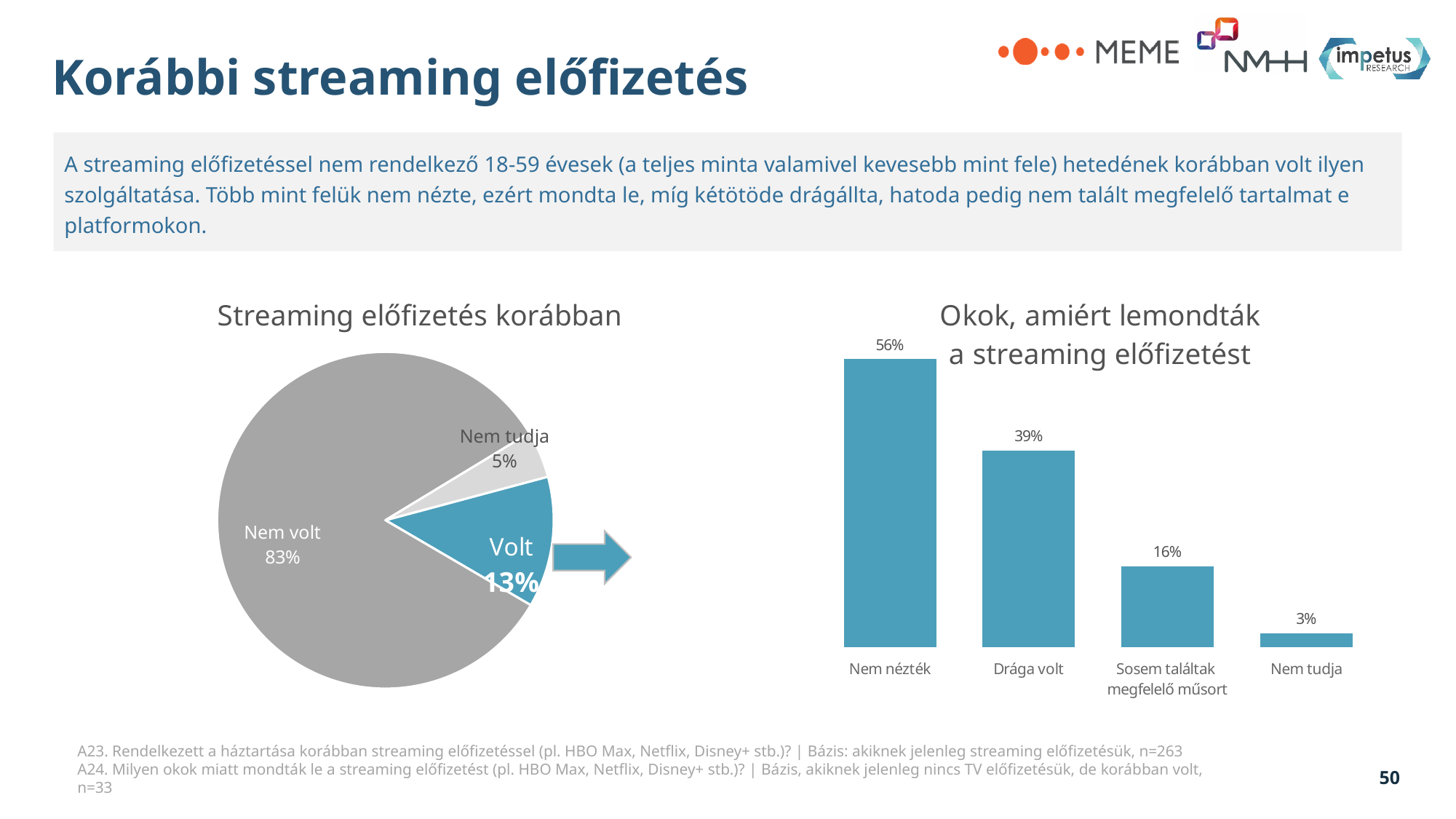
In the 'Okok, amiért lemondták a streaming előfizetést' chart, which category has the highest value? Nem nézték In the 'Streaming előfizetés korábban' chart, what share is labelled 'Nem tudja'? 5% What kind of chart is 'Okok, amiért lemondták a streaming előfizetést'? bar chart In the 'Streaming előfizetés korábban' chart, what share is labelled 'Volt'? 13% In the 'Okok, amiért lemondták a streaming előfizetést' chart, which category has the lowest value? Nem tudja How many categories are shown in the 'Okok, amiért lemondták a streaming előfizetést' chart? 4 What kind of chart is 'Streaming előfizetés korábban'? pie chart In the 'Okok, amiért lemondták a streaming előfizetést' chart, what is the value for 'Sosem találtak megfelelő műsort'? 16% In the 'Okok, amiért lemondták a streaming előfizetést' chart, what is the difference between 'Nem nézték' and 'Drága volt'? 17 percentage points In the 'Streaming előfizetés korábban' chart, what share is labelled 'Nem volt'? 83% In the 'Okok, amiért lemondták a streaming előfizetést' chart, what is the value for 'Drága volt'? 39% In the 'Streaming előfizetés korábban' chart, which slice is the largest? Nem volt